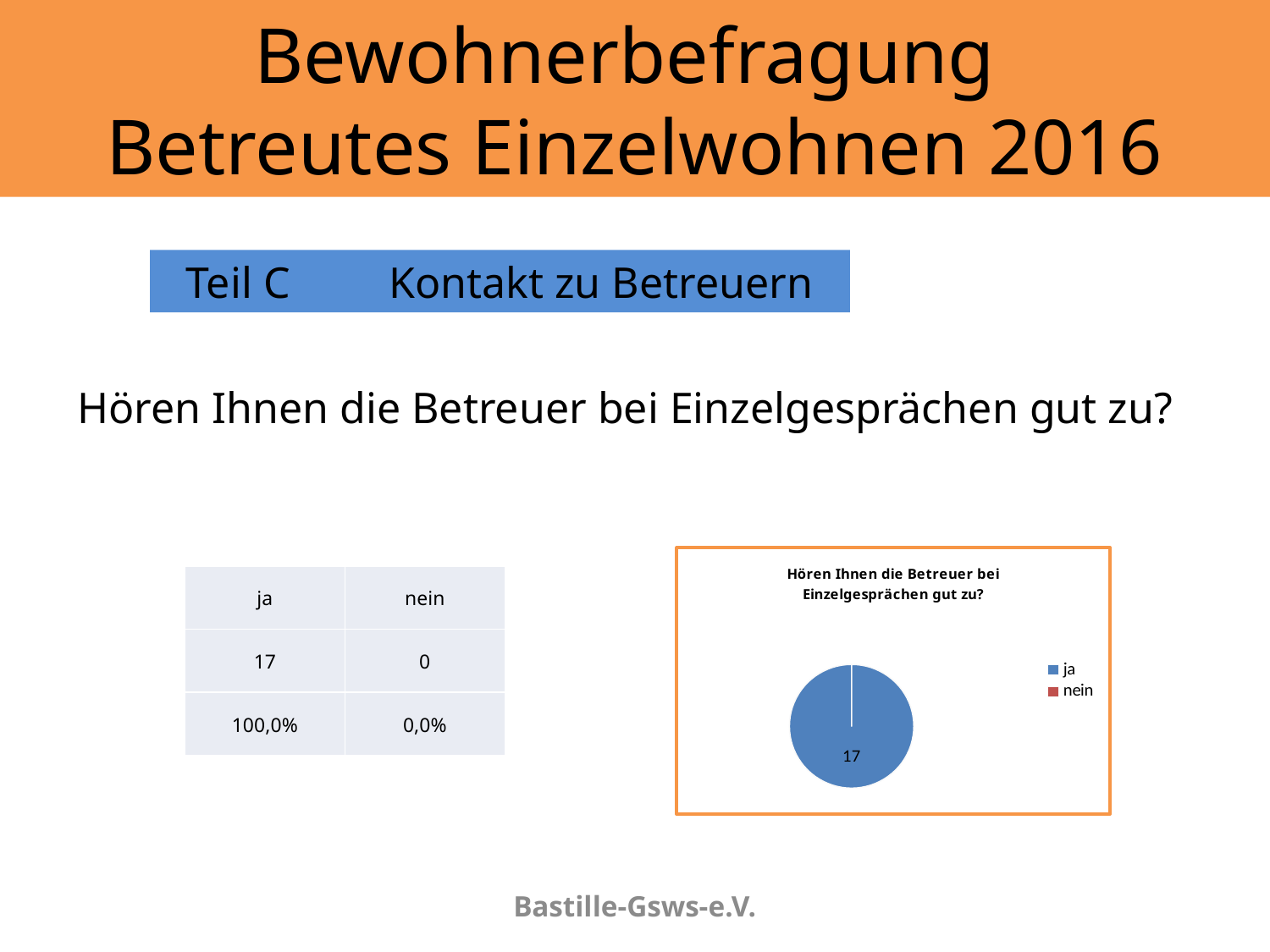
Which is larger in the pie chart, "ja" or "nein"? ja What kind of chart is shown on the slide? pie chart What is the value for "ja" in the pie chart? 17 What is the title of the pie chart? Hören Ihnen die Betreuer bei Einzelgesprächen gut zu? Which category has the largest slice in the pie chart? ja How many entries does the legend of the pie chart list? 2 What share of the pie does the "ja" slice take? 100,0% What colour is the "ja" slice in the pie chart? blue Is the value for "ja" in the pie chart greater or less than 10? greater